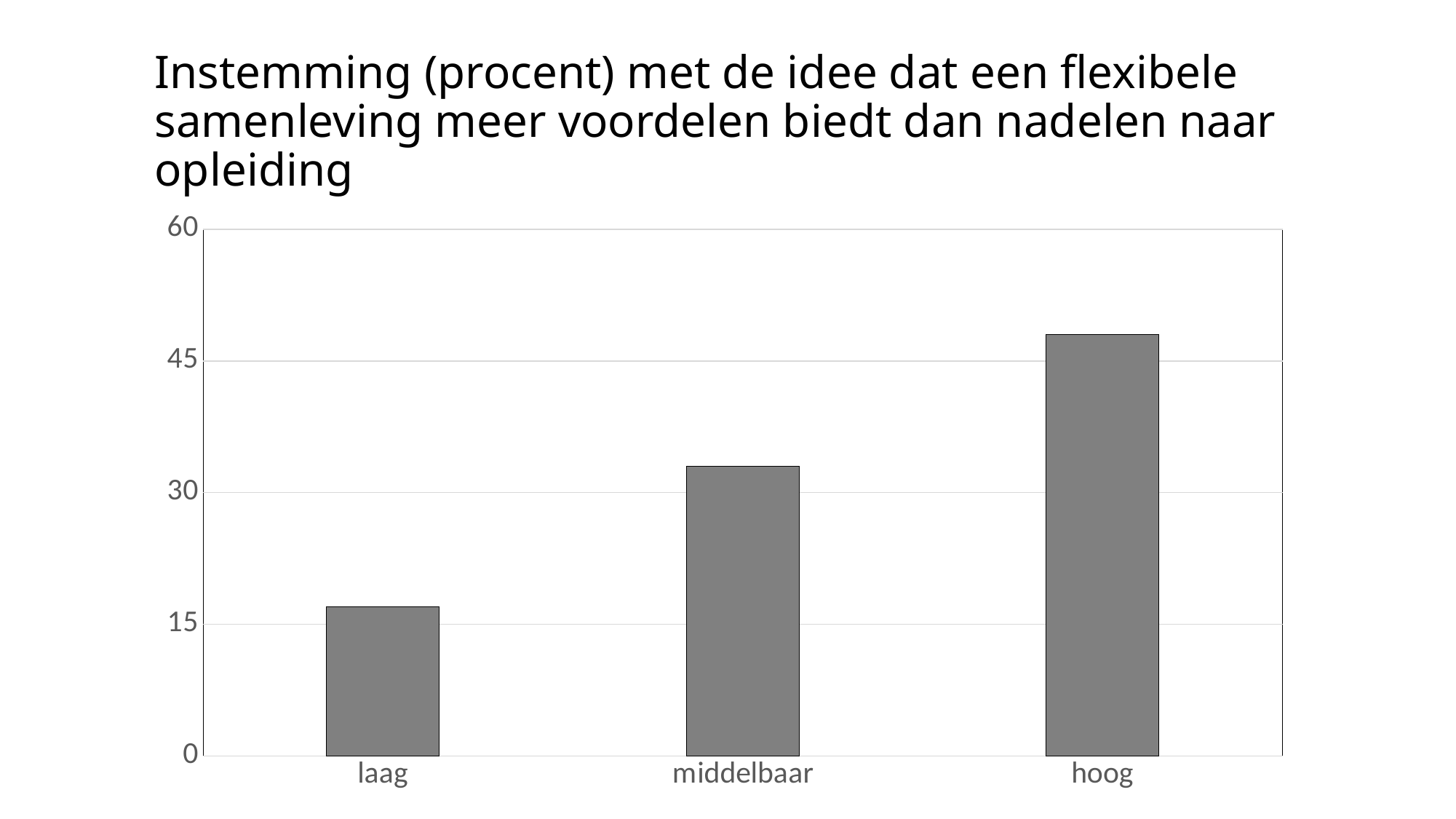
Which is larger, the value for hoog or the value for middelbaar? hoog Is the value for hoog greater or less than 60? less Which is larger, the value for middelbaar or the value for laag? middelbaar Is the value for middelbaar greater or less than 30? greater Do the values rise or fall from laag to hoog along the x axis? rise Is the value for laag greater or less than 30? less Which category has the highest bar? hoog What kind of chart is shown on the slide? bar chart Which category has the lowest bar? laag How many categories are shown on the x axis? 3